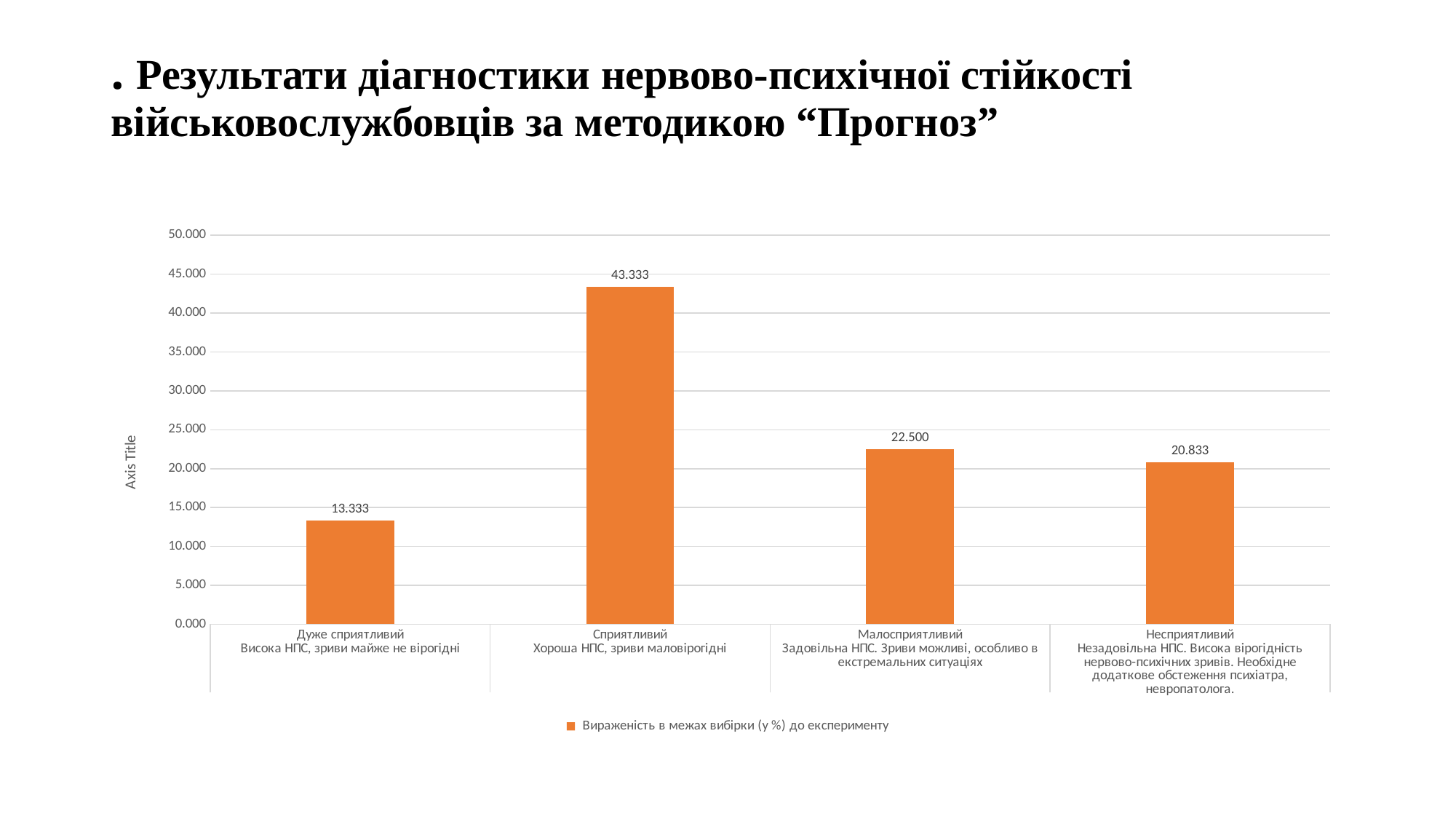
Which is larger, the value for "Малосприятливий" or the value for "Несприятливий"? Малосприятливий What series name does the legend show? Вираженість в межах вибірки (у %) до експерименту What is the difference between the values for "Сприятливий" and "Малосприятливий"? 20.833 What is the value for the "Малосприятливий" category? 22.500 What is the value for the "Сприятливий" category? 43.333 Which category has the highest value? Сприятливий What kind of chart is shown on the slide? bar chart How many categories are shown on the chart? 4 Is the value for "Сприятливий" greater or less than 40.000? greater Which category has the lowest value? Дуже сприятливий What is the value for the "Несприятливий" category? 20.833 What is the value for the "Дуже сприятливий" category? 13.333